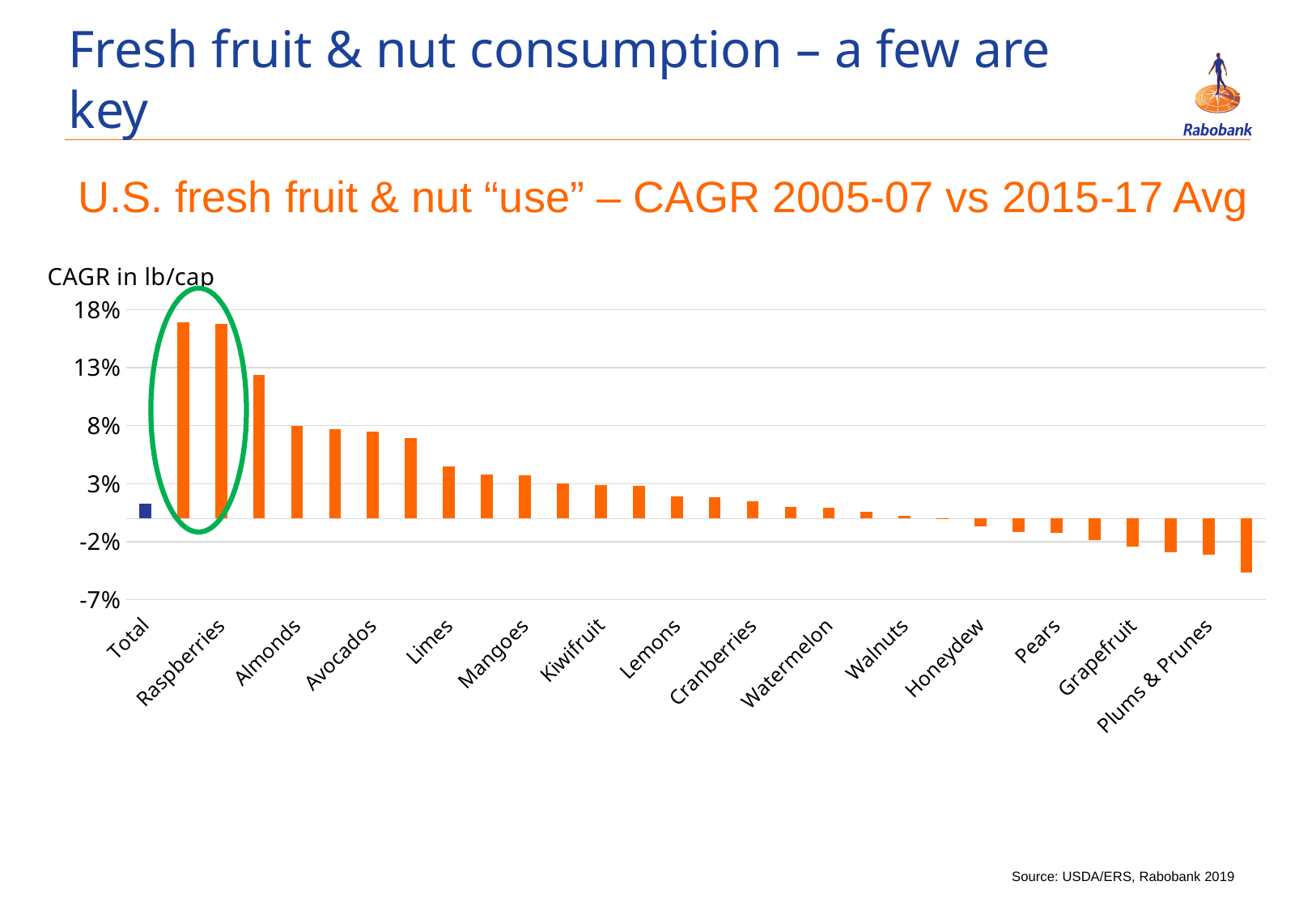
Is the value for Total greater or less than 3%? less Is the value for Pears greater or less than 3%? less How many category labels are shown on the x axis? 15 Is the value for Avocados greater or less than 3%? greater Do the values of the orange bars rise or fall from left to right along the x axis? fall Which is larger, the value for Almonds or the value for Plums & Prunes? Almonds What kind of chart is shown on the slide? bar chart What colour is the bar for Total? blue What is the label on the vertical axis of the chart? CAGR in lb/cap Which is larger, the value for Raspberries or the value for Almonds? Raspberries